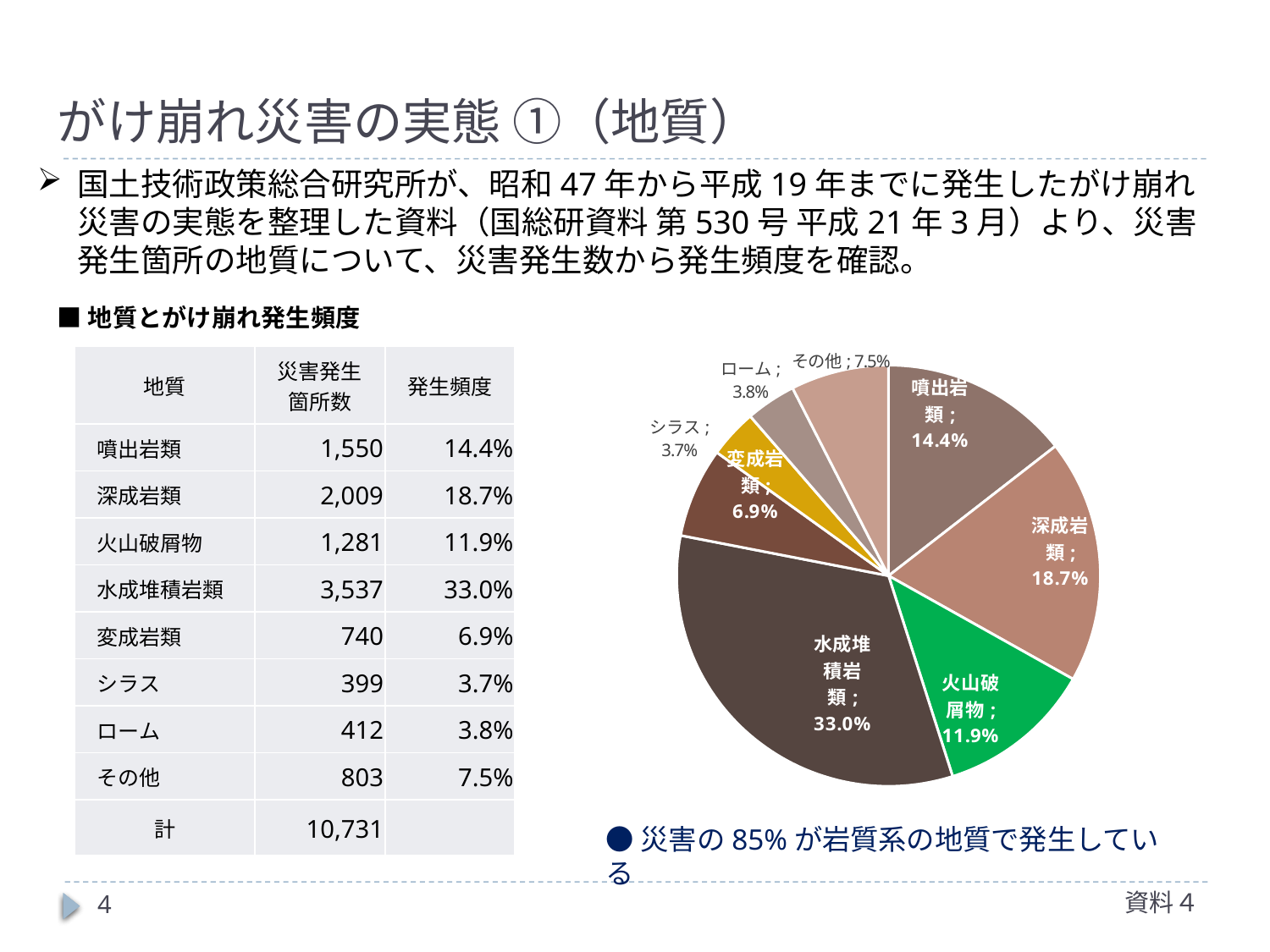
What percentage does the pie chart show for その他? 7.5% What is the difference in percentage points between 水成堆積岩類 and 深成岩類 in the pie chart? 14.3 What percentage does the pie chart show for 火山破屑物? 11.9% What percentage does the pie chart show for 深成岩類? 18.7% How many slices does the pie chart have? 8 What kind of chart is shown on the slide? pie chart What percentage does the pie chart show for ローム? 3.8% Which category has the largest slice in the pie chart? 水成堆積岩類 What is the difference in percentage points between 噴出岩類 and 火山破屑物 in the pie chart? 2.5 What percentage does the pie chart show for 水成堆積岩類? 33.0% Which category has the smallest slice in the pie chart? シラス In the pie chart, which is larger: 噴出岩類 or 変成岩類? 噴出岩類